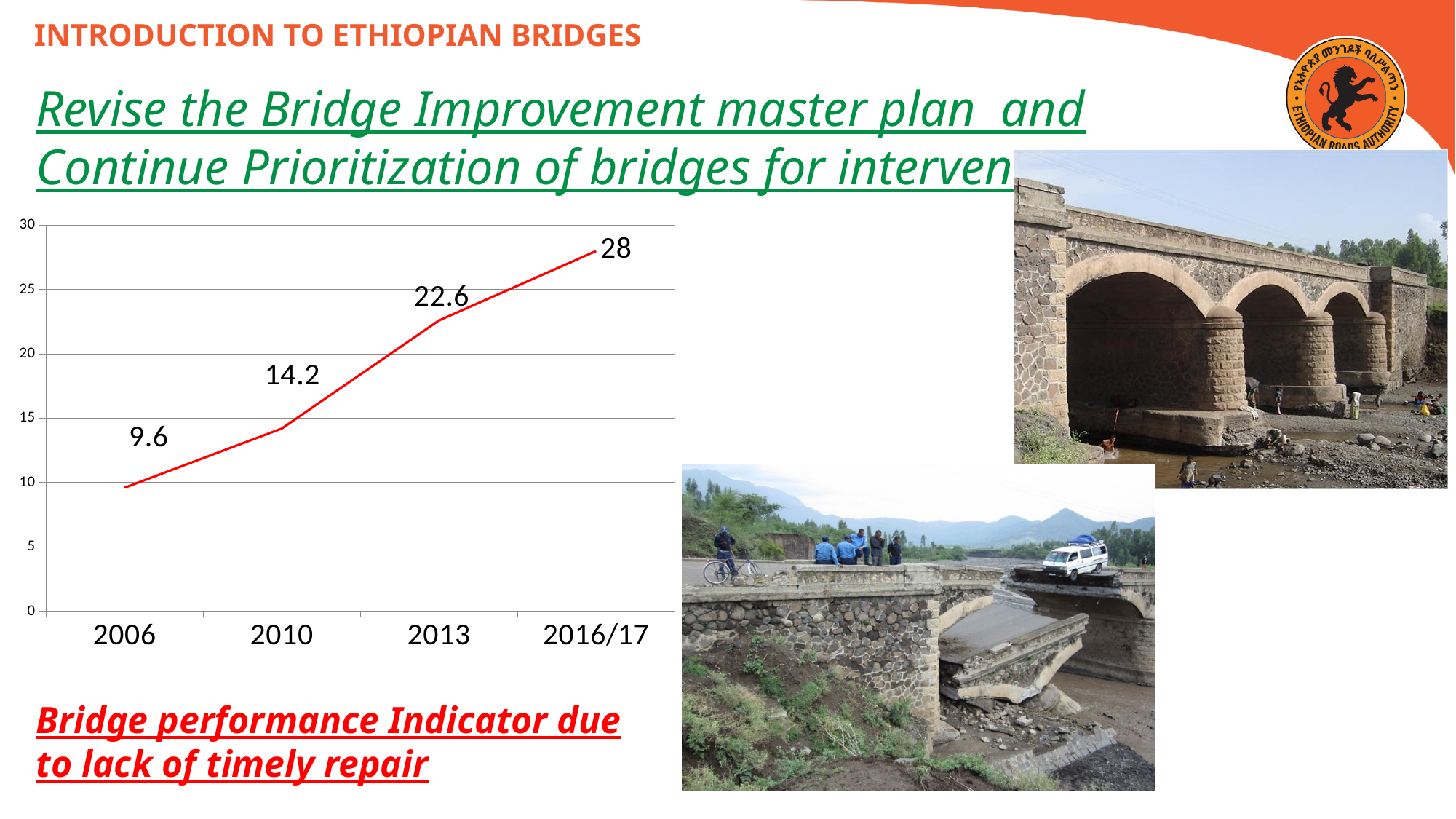
What is the difference between the values for 2013 and 2010? 8.4 What kind of chart is shown on the slide? Line chart What is the value for 2006? 9.6 What is the value for 2016/17? 28 Do the values rise or fall from 2006 to 2016/17? Rise Which is larger, the value for 2010 or the value for 2013? 2013 Which year has the highest value? 2016/17 What is the difference between the values for 2016/17 and 2006? 18.4 How many data points are plotted on the chart? 4 What is the value for 2010? 14.2 Which year has the lowest value? 2006 What is the value for 2013? 22.6